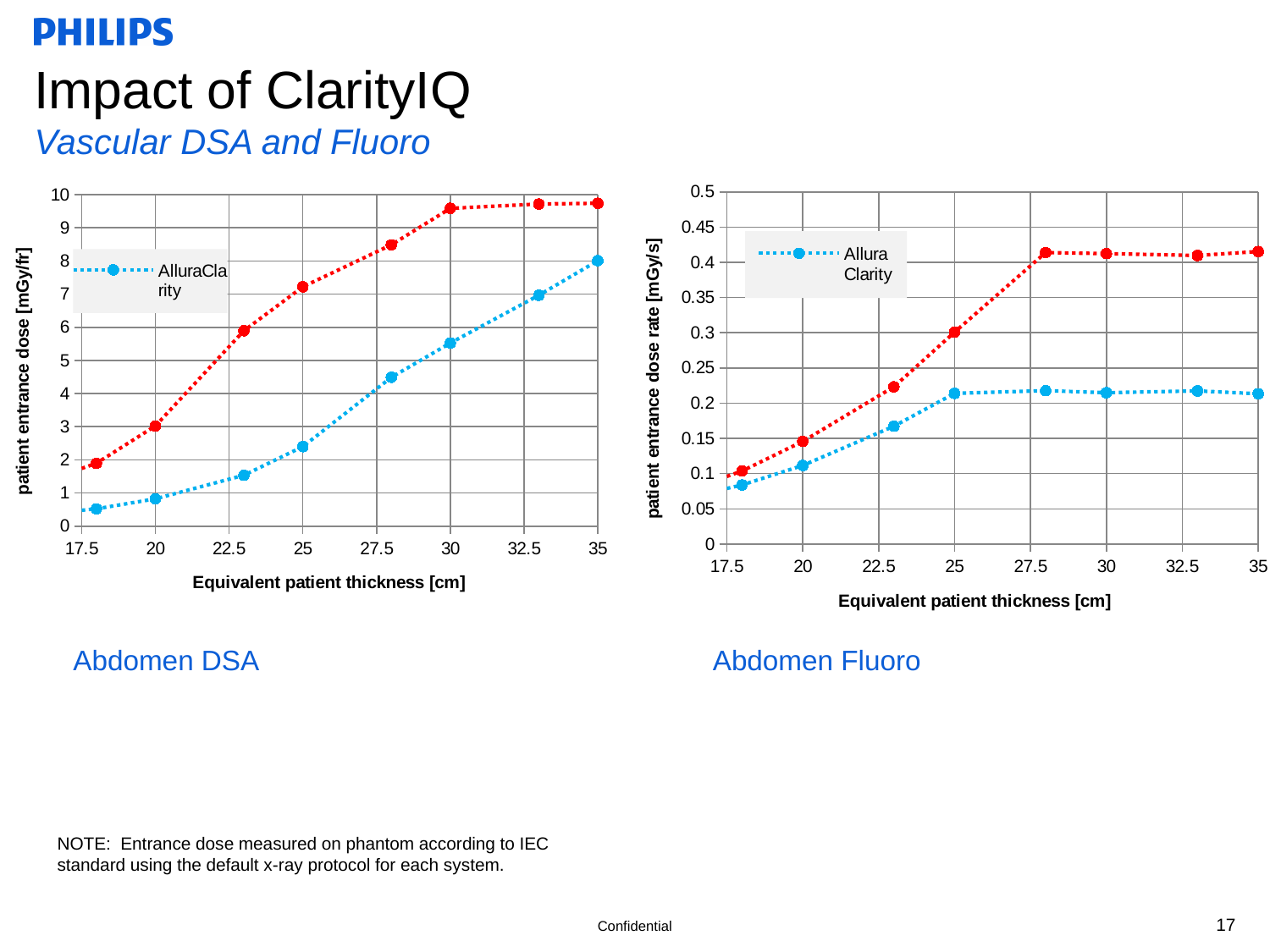
In the Abdomen Fluoro chart, how does the AlluraClarity dose rate behave as thickness increases from 17.5 to 35 cm? rises, then levels off from 25 cm What kind of chart is the Abdomen DSA chart on the left? line chart In the Abdomen DSA chart, at which equivalent patient thickness is the AlluraClarity entrance dose highest? 35 cm In the Abdomen DSA chart, at 25 cm, which series has the higher entrance dose: the red series or the blue AlluraClarity series? the red series What is the y-axis title of the Abdomen Fluoro chart? patient entrance dose rate [mGy/s] In the Abdomen Fluoro chart, is the red series value at 30 cm greater or less than 0.35 mGy/s? greater How many data points does the AlluraClarity series have in the Abdomen DSA chart? 8 In the Abdomen DSA chart, is the AlluraClarity value at 35 cm greater or less than 7 mGy/fr? greater In the Abdomen Fluoro chart, is the AlluraClarity value at 30 cm greater or less than 0.25 mGy/s? less How many series does the legend of the Abdomen Fluoro chart list? 1 In the Abdomen DSA chart, does the AlluraClarity patient entrance dose rise or fall as equivalent patient thickness increases? rises